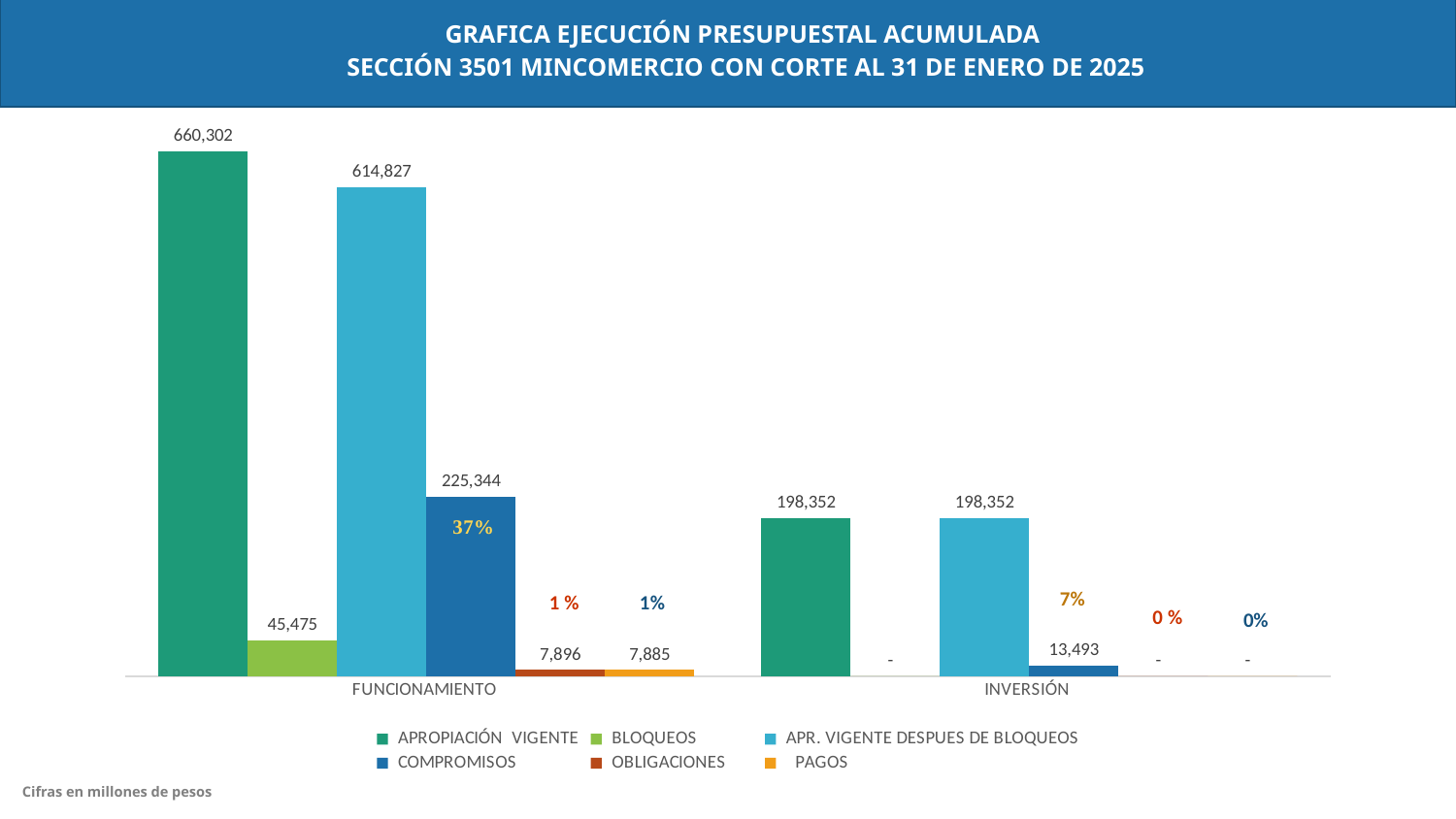
How many series does the legend list? 6 How many categories are shown on the x axis? 2 What is the value of APR. VIGENTE DESPUES DE BLOQUEOS for FUNCIONAMIENTO? 614,827 What is the value of COMPROMISOS for INVERSIÓN? 13,493 What percentage is shown above the COMPROMISOS bar for FUNCIONAMIENTO? 37% Which is larger: APROPIACIÓN VIGENTE for FUNCIONAMIENTO or APROPIACIÓN VIGENTE for INVERSIÓN? FUNCIONAMIENTO Which series has the highest value for FUNCIONAMIENTO? APROPIACIÓN VIGENTE What is the difference between APROPIACIÓN VIGENTE and APR. VIGENTE DESPUES DE BLOQUEOS for FUNCIONAMIENTO? 45,475 What kind of chart is shown on the slide? Bar chart What is the difference between COMPROMISOS for FUNCIONAMIENTO and COMPROMISOS for INVERSIÓN? 211,851 What is the value of APROPIACIÓN VIGENTE for FUNCIONAMIENTO? 660,302 What is the value of BLOQUEOS for FUNCIONAMIENTO? 45,475